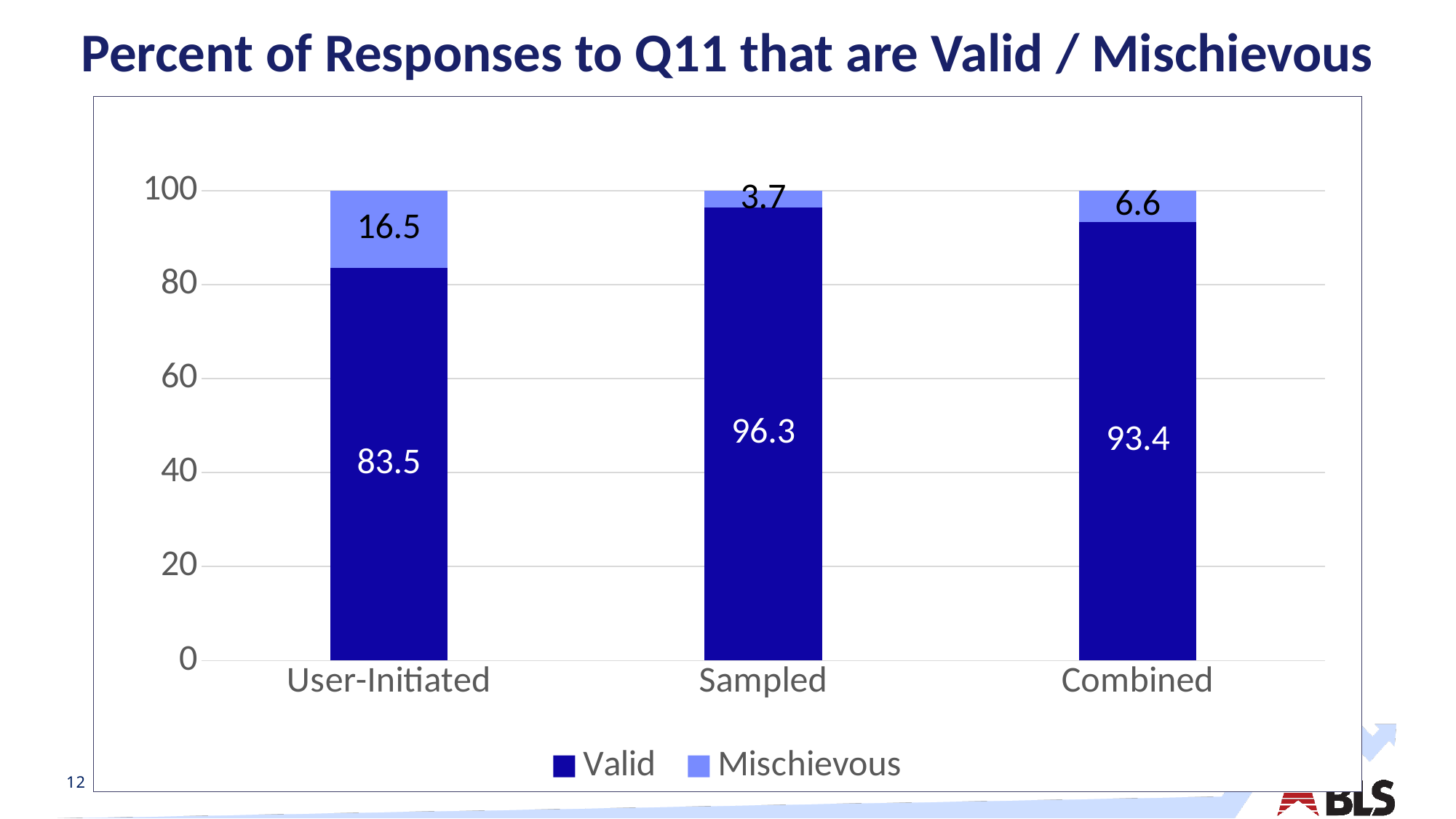
Which category has the lowest Mischievous value? Sampled Which category has the highest Valid value? Sampled What kind of chart is shown? Stacked bar chart Which is larger, the Valid value for User-Initiated or the Valid value for Combined? Combined What is the Mischievous value for Combined? 6.6 How many series does the legend list? 2 What is the Mischievous value for Sampled? 3.7 What is the difference between the Mischievous values for User-Initiated and Combined? 9.9 What is the Valid value for Combined? 93.4 What is the total of the stacked bar for User-Initiated? 100 What is the Valid value for User-Initiated? 83.5 How many categories are shown on the x axis? 3